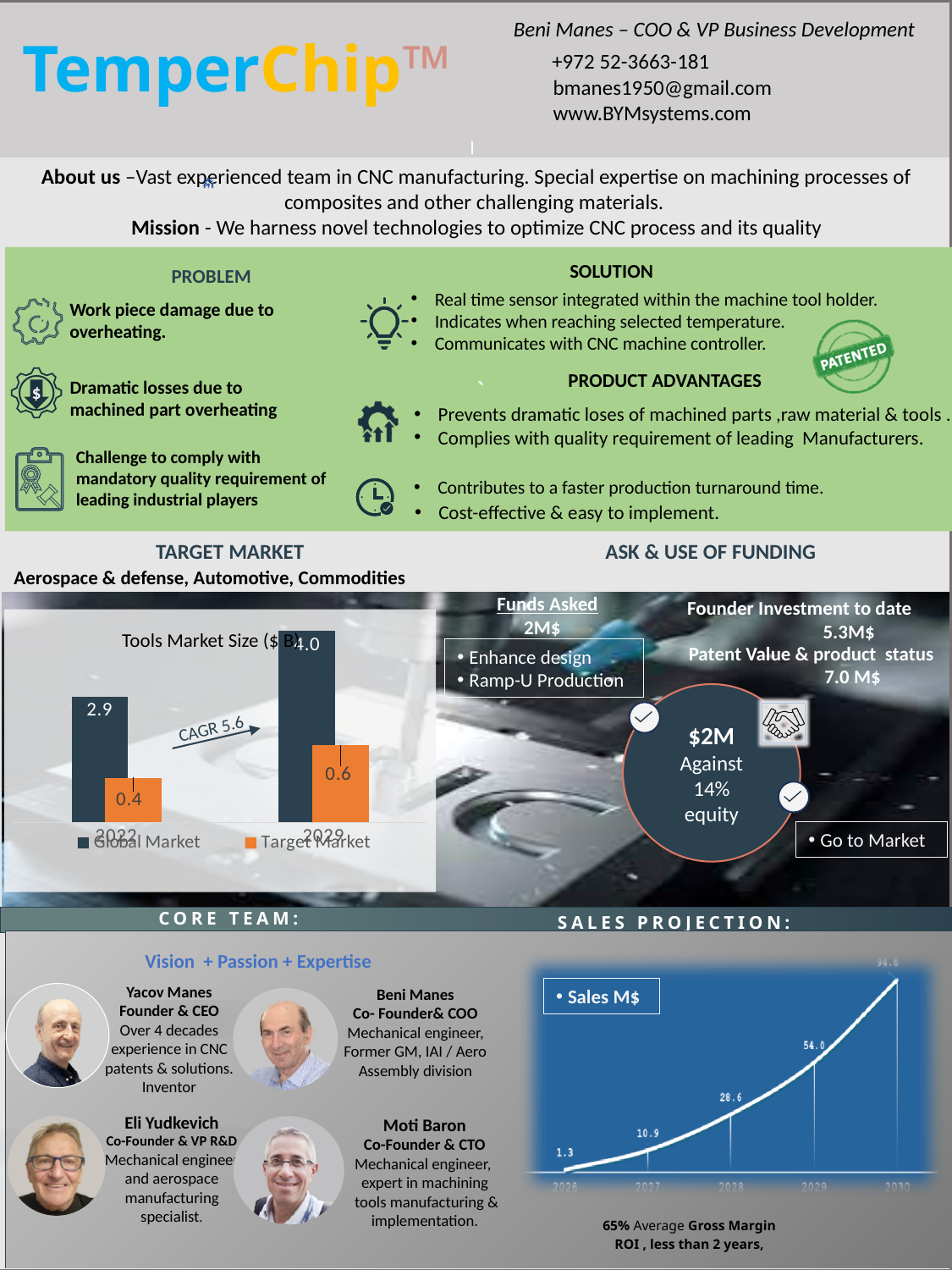
In the Tools Market Size ($ B) chart, what is the Global Market value for 2022? 2.9 In the Tools Market Size ($ B) chart, what is the Global Market value for 2029? 4.0 In the Tools Market Size ($ B) chart, what is the Target Market value for 2022? 0.4 In the Sales Projection chart, what is the Sales M$ value for 2028? 28.6 In the Tools Market Size ($ B) chart, what is the difference between the Global Market values for 2029 and 2022? 1.1 In the Sales Projection chart, what is the Sales M$ value for 2030? 94.6 In the Tools Market Size ($ B) chart, what is the Target Market value for 2029? 0.6 In the Sales Projection chart, do the Sales M$ values rise or fall from 2026 to 2030? Rise In the Tools Market Size ($ B) chart, what CAGR is shown on the arrow between 2022 and 2029? CAGR 5.6 In the Tools Market Size ($ B) chart, how many series does the legend list? 2 What kind of chart is the Tools Market Size ($ B) chart? Bar chart In the Sales Projection chart, which year has the lowest Sales M$ value? 2026